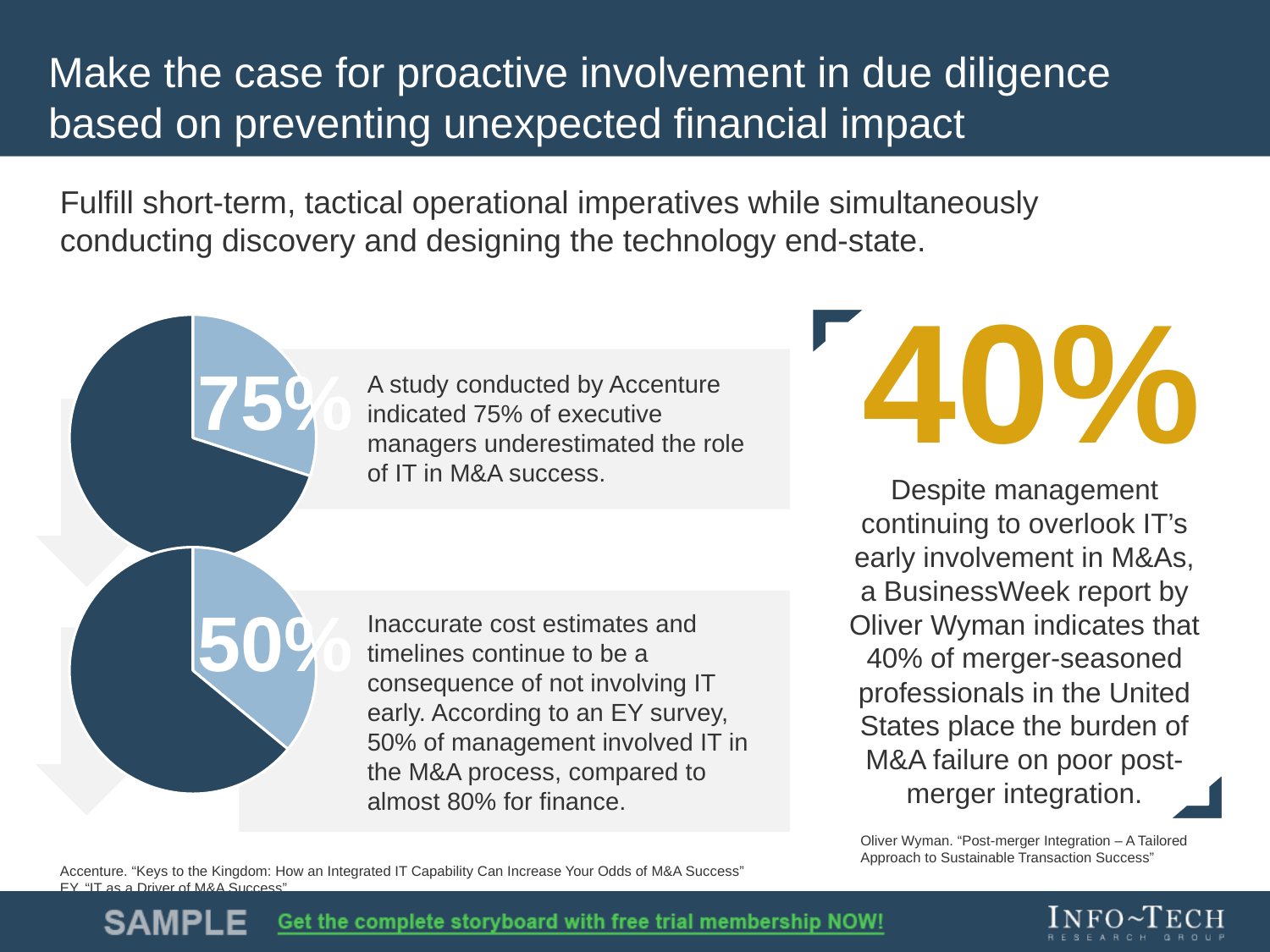
According to the text next to the bottom pie chart, what percentage of management involved finance in the M&A process? Almost 80% What percentage is labeled on the bottom pie chart? 50% What is the difference between the percentage labeled on the top pie chart and the percentage labeled on the bottom pie chart? 25% What percentage is labeled on the top pie chart? 75% Which pie chart shows the larger labeled percentage, the top one or the bottom one? The top one (75%) What two colours are used for the slices in the pie charts? Dark blue and light blue According to the text next to the top pie chart, which firm conducted the study that found 75% of executive managers underestimated the role of IT in M&A success? Accenture Is the percentage labeled on the top pie chart greater or less than 50%? greater How many pie charts are shown on the slide? 2 What kind of chart is used on the left side of the slide? Pie chart